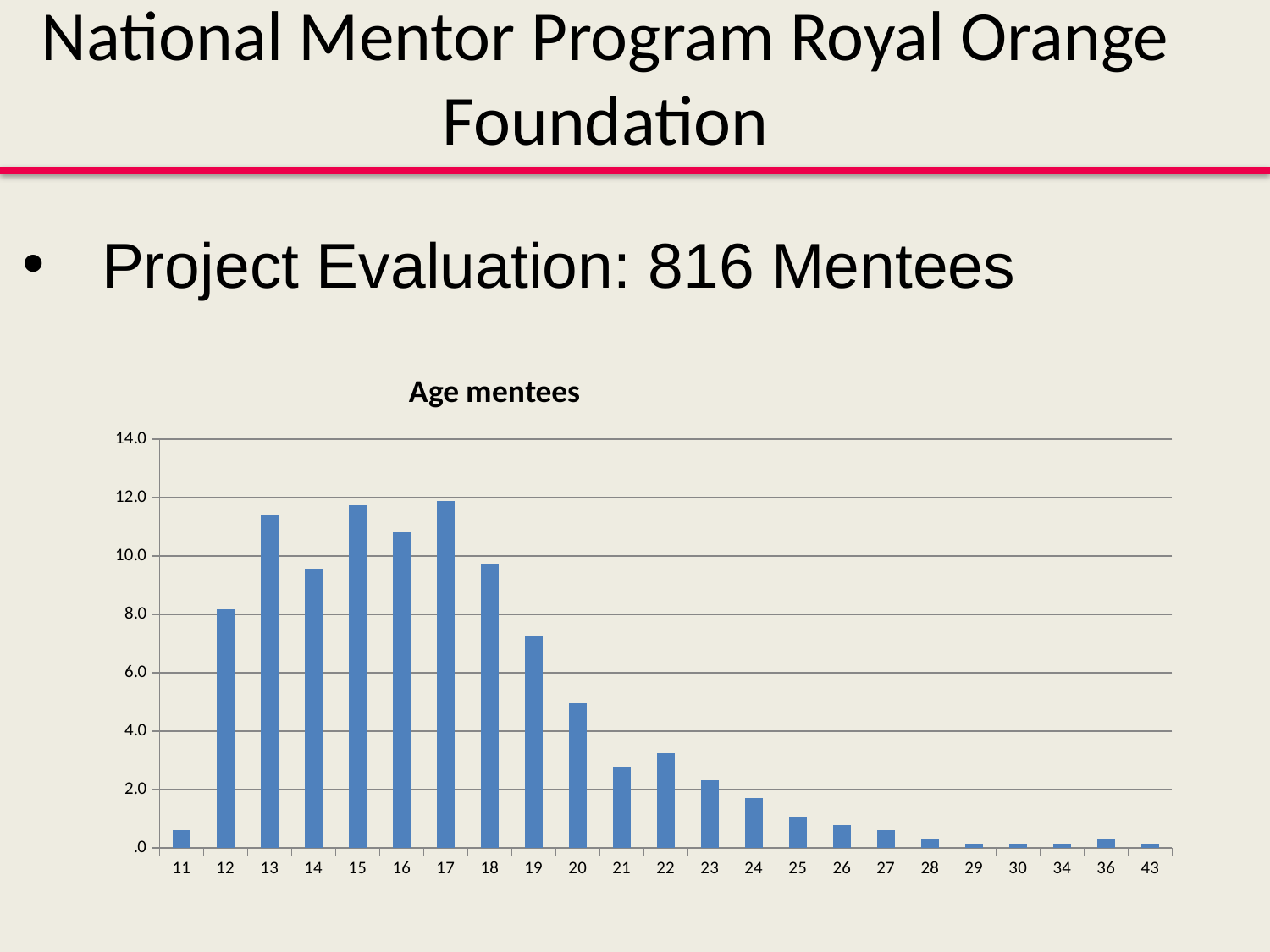
Is the value for age 20 greater or less than 6.0? less What colour are the bars in the chart? blue Which has the larger value, age 13 or age 14? 13 Is the value for age 13 greater or less than 10.0? greater What is the title of the chart? Age mentees Which has the larger value, age 22 or age 21? 22 Do the values rise or fall along the x axis from age 17 to age 29? fall Is the value for age 19 greater or less than 6.0? greater What kind of chart is shown on the slide? bar chart How many age categories are shown on the x axis of the chart? 23